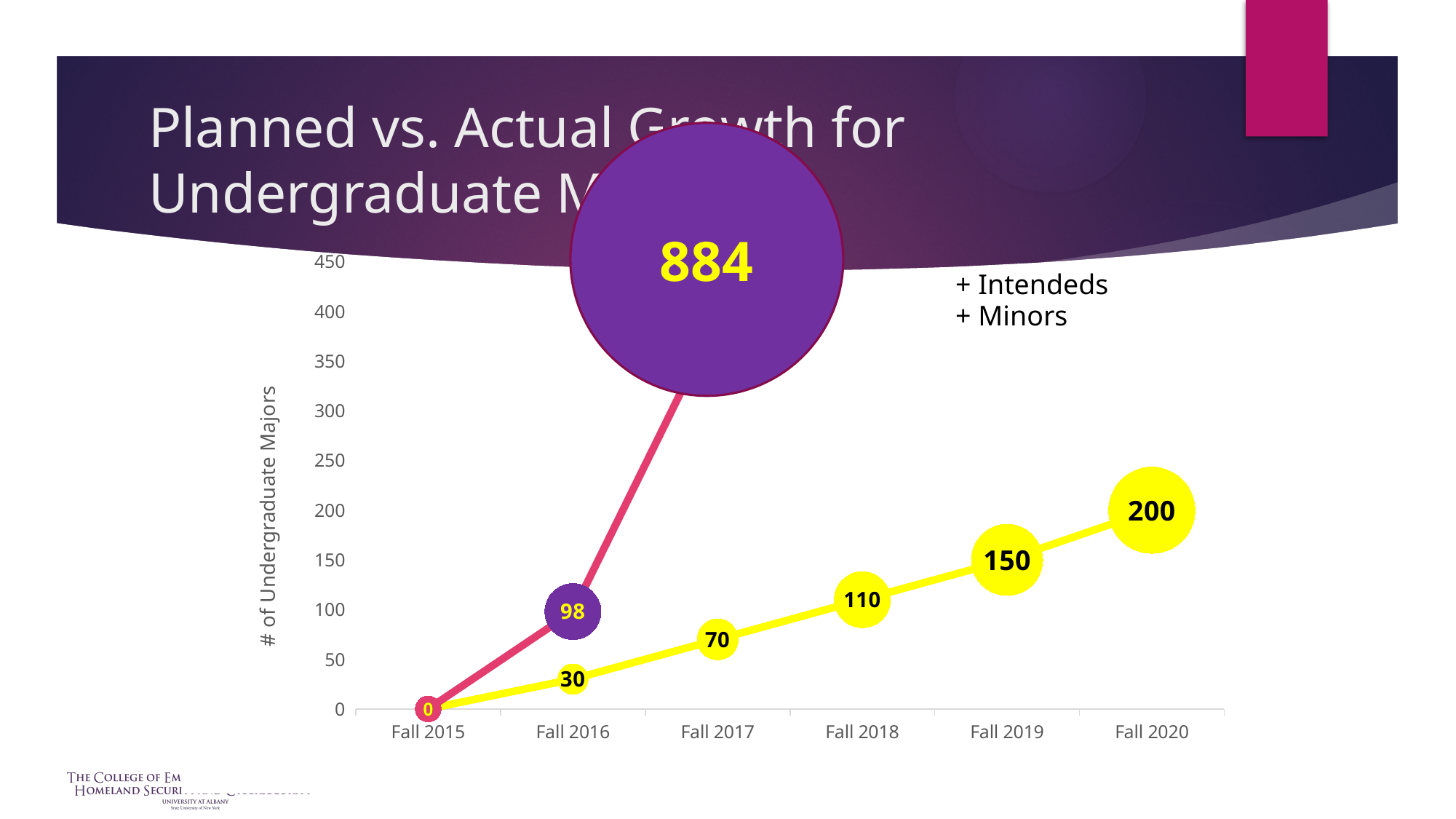
How many categories are shown on the x axis? 6 What is the value of the purple/pink line at Fall 2016? 98 Which point on the yellow line has the highest value? Fall 2020 What value is shown in the large purple bubble at Fall 2017? 884 What is the value of the yellow line at Fall 2016? 30 At Fall 2016, which line has the larger value, the yellow line or the purple/pink line? the purple/pink line What is the value of the yellow line at Fall 2020? 200 Do the values of the yellow line rise or fall from Fall 2016 to Fall 2020? rise What is the label on the vertical axis of the chart? # of Undergraduate Majors What is the difference between the yellow line's values at Fall 2020 and Fall 2019? 50 What kind of chart is shown on the slide? line chart What is the value of the yellow line at Fall 2018? 110